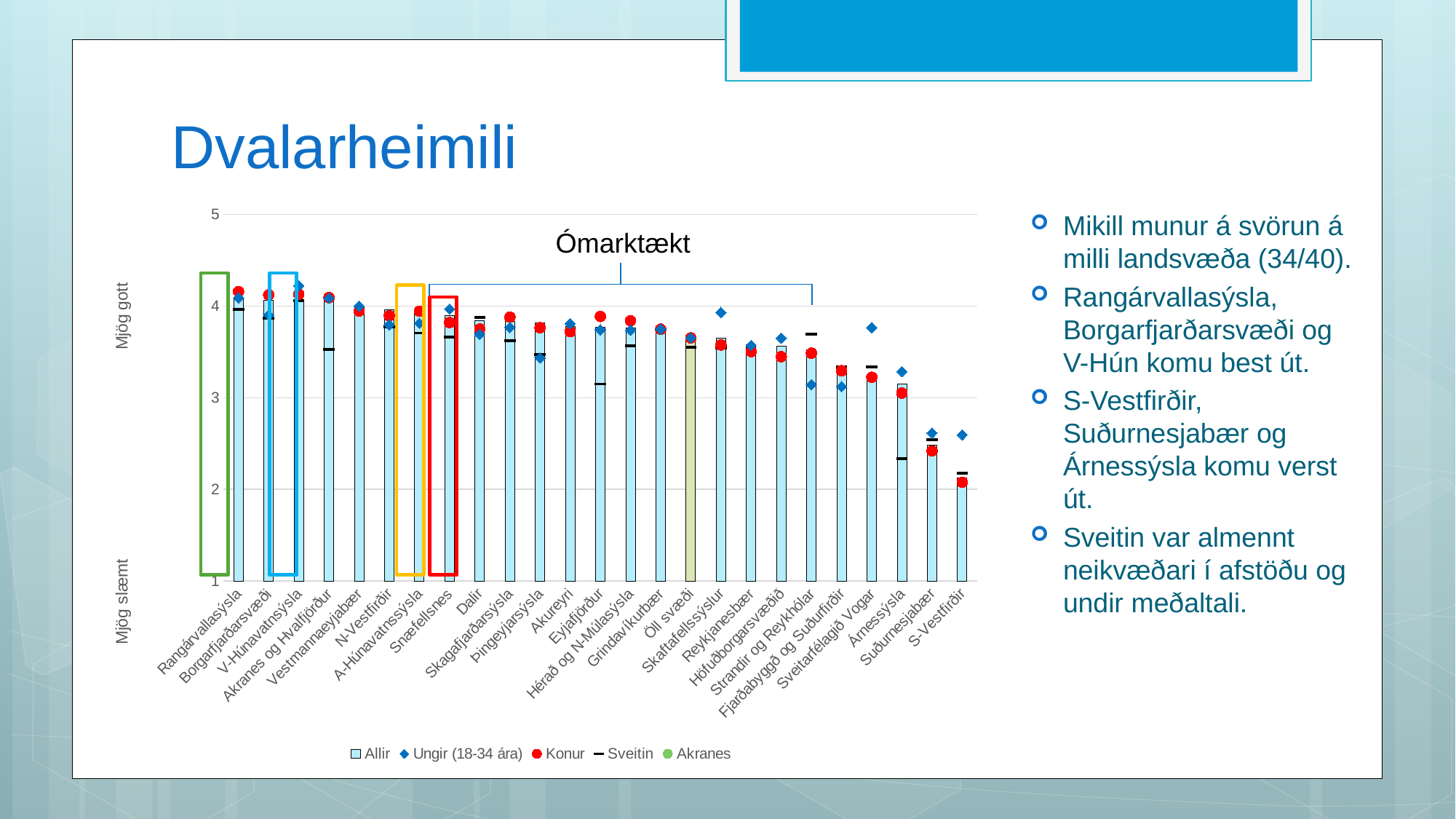
Which has the larger Allir bar, Rangárvallasýsla or S-Vestfirðir? Rangárvallasýsla Is the Allir value for S-Vestfirðir greater or less than 3? less Do the Allir bars rise or fall from left to right along the x axis? fall Is the Allir value for Akureyri greater or less than 3? greater Which category has the lowest Allir bar in the chart? S-Vestfirðir Is the Allir value for Rangárvallasýsla greater or less than 4? greater What kind of chart is shown on the slide? bar chart Which has the larger Allir bar, Akureyri or Árnessýsla? Akureyri How many categories are shown along the x axis of the chart? 25 What is the title of the slide containing the chart? Dvalarheimili How many series does the chart legend list? 5